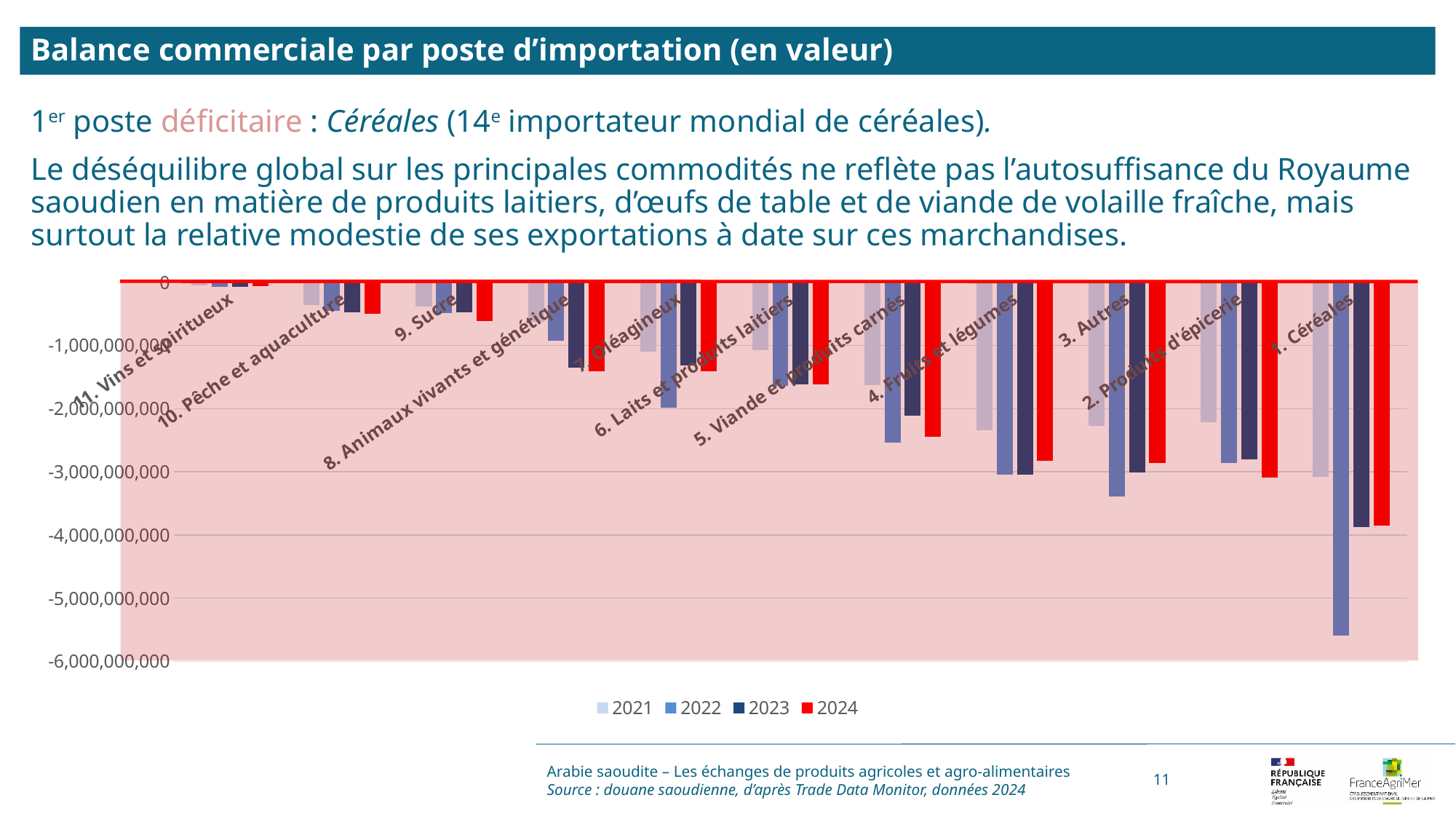
Which category has the highest value (closest to zero) for 2024? 11. Vins et spiritueux Which years are listed in the legend? 2021, 2022, 2023, 2024 Which colour represents 2024 in the chart? red Is the value for 1. Céréales in 2022 greater or less than -5,000,000,000? less How many import categories are plotted on the x axis? 11 How many series does the legend list? 4 Do the 2024 values generally rise or fall moving from left to right along the x axis? fall Which is larger, the 2024 value for 9. Sucre or the 2024 value for 1. Céréales? 9. Sucre Is the value for 4. Fruits et légumes in 2024 greater or less than -2,000,000,000? less Is the value for 11. Vins et spiritueux in 2024 greater or less than -1,000,000,000? greater What kind of chart is shown on the slide? bar chart Which category has the lowest (most negative) value for 2022? 1. Céréales